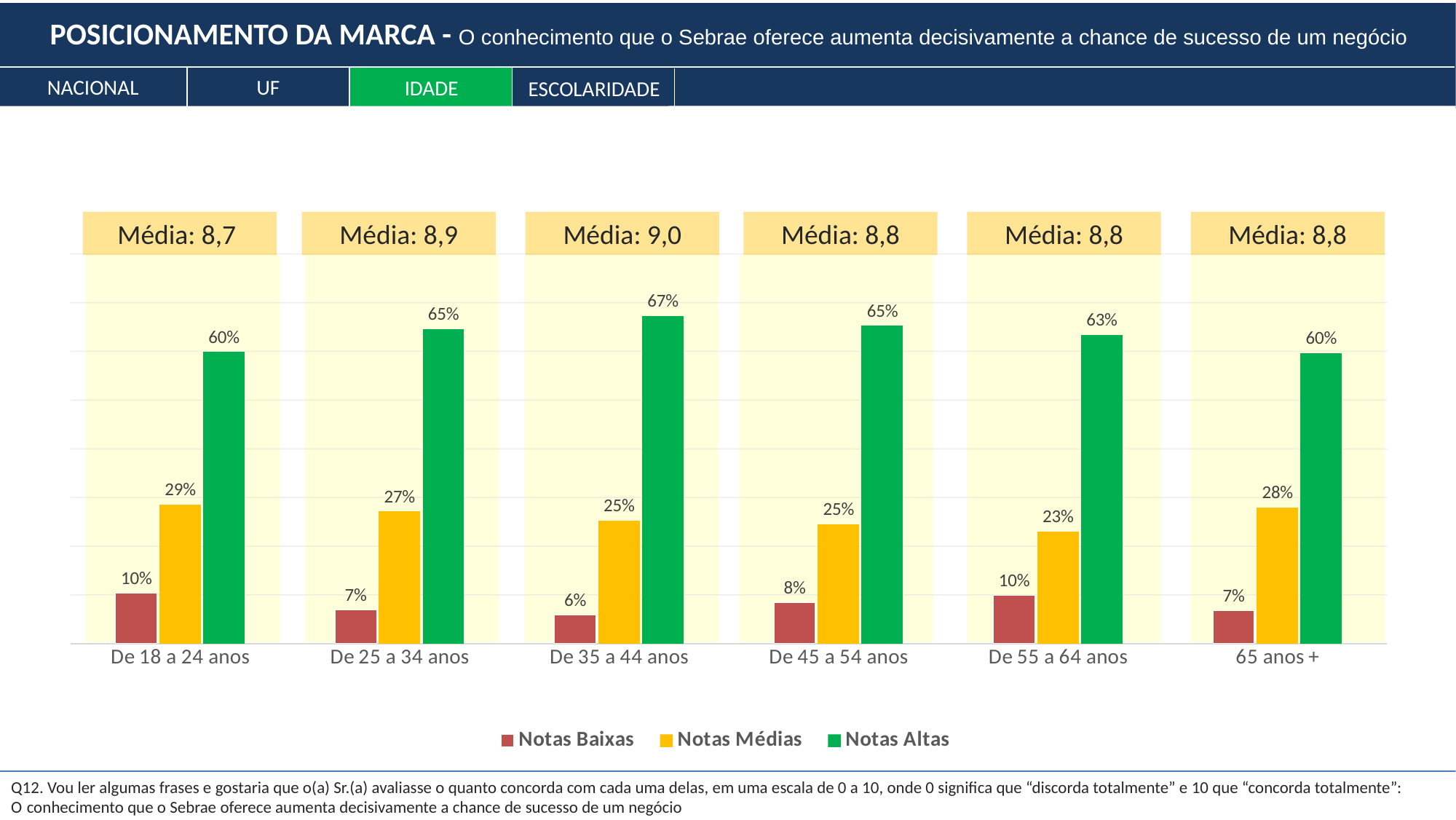
What is the value of Notas Baixas for the 'De 18 a 24 anos' age group? 10% Which is larger: Notas Médias for 'De 18 a 24 anos' or Notas Médias for 'De 45 a 54 anos'? De 18 a 24 anos Which age group has the lowest Notas Baixas value? De 35 a 44 anos What is the value of Notas Altas for the 'De 35 a 44 anos' age group? 67% How many age groups are shown on the x axis? 6 What is the Média shown above the 'De 25 a 34 anos' age group? 8,9 How many series does the legend list? 3 What kind of chart is shown on the slide? Bar chart Which colour represents Notas Altas in the legend? Green What is the difference between Notas Altas and Notas Médias for the 'De 55 a 64 anos' age group? 40% What is the value of Notas Médias for the '65 anos +' age group? 28% Which age group has the highest Notas Altas value? De 35 a 44 anos